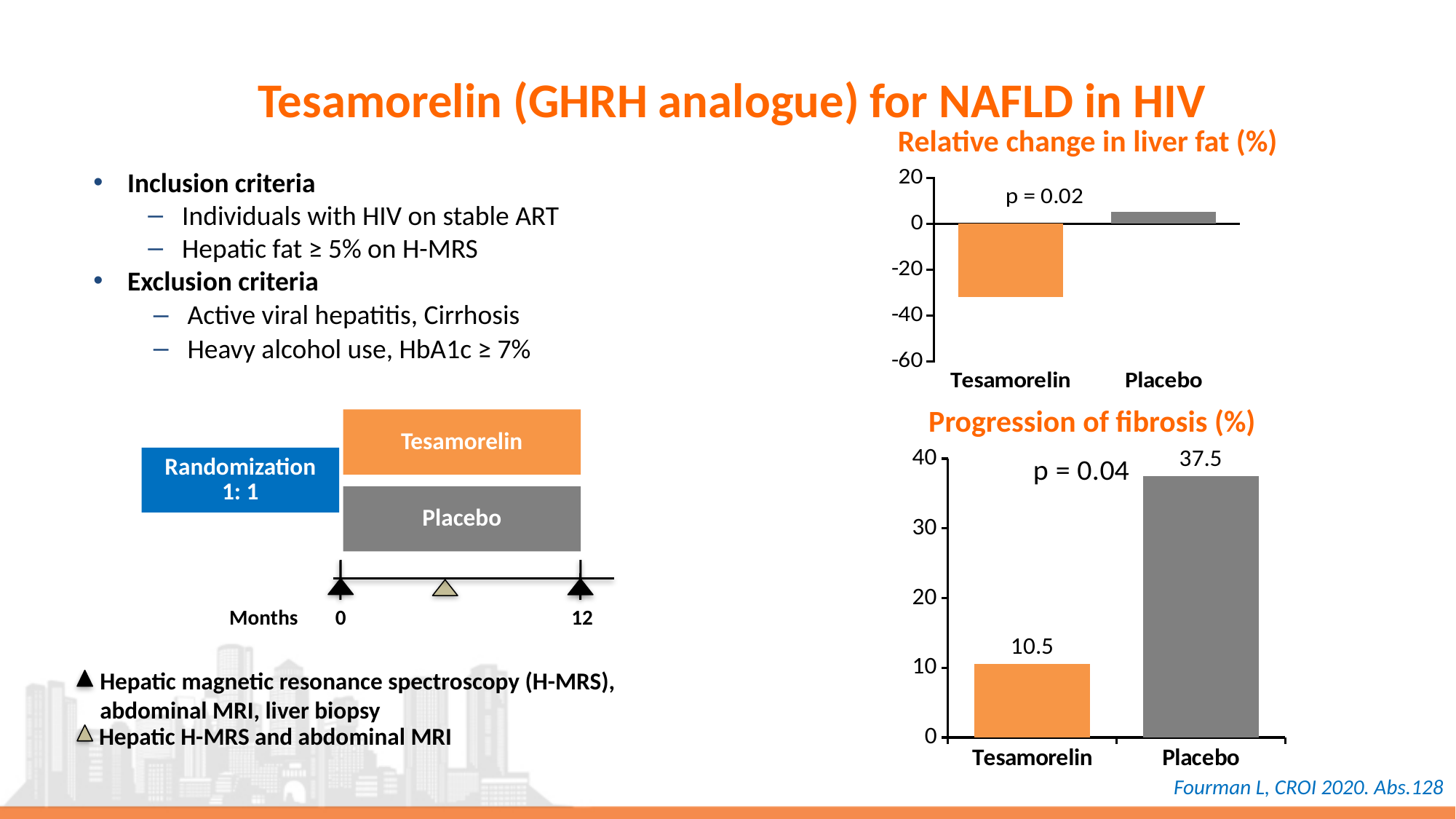
In the 'Relative change in liver fat (%)' chart, is the value for Placebo greater or less than 0? greater In the 'Progression of fibrosis (%)' chart, what is the difference between the Placebo and Tesamorelin values? 27 What kind of chart is the 'Relative change in liver fat (%)' chart? Bar chart In the 'Progression of fibrosis (%)' chart, which group has the lowest value? Tesamorelin In the 'Progression of fibrosis (%)' chart, which group has the higher value? Placebo In the 'Relative change in liver fat (%)' chart, which group has the lower value, Tesamorelin or Placebo? Tesamorelin How many categories are shown in the 'Progression of fibrosis (%)' chart? 2 In the 'Relative change in liver fat (%)' chart, is the value for Tesamorelin greater or less than -20? less What p-value is shown on the 'Progression of fibrosis (%)' chart? p = 0.04 In the 'Progression of fibrosis (%)' chart, what is the value for Placebo? 37.5 What p-value is shown on the 'Relative change in liver fat (%)' chart? p = 0.02 In the 'Progression of fibrosis (%)' chart, what is the value for Tesamorelin? 10.5